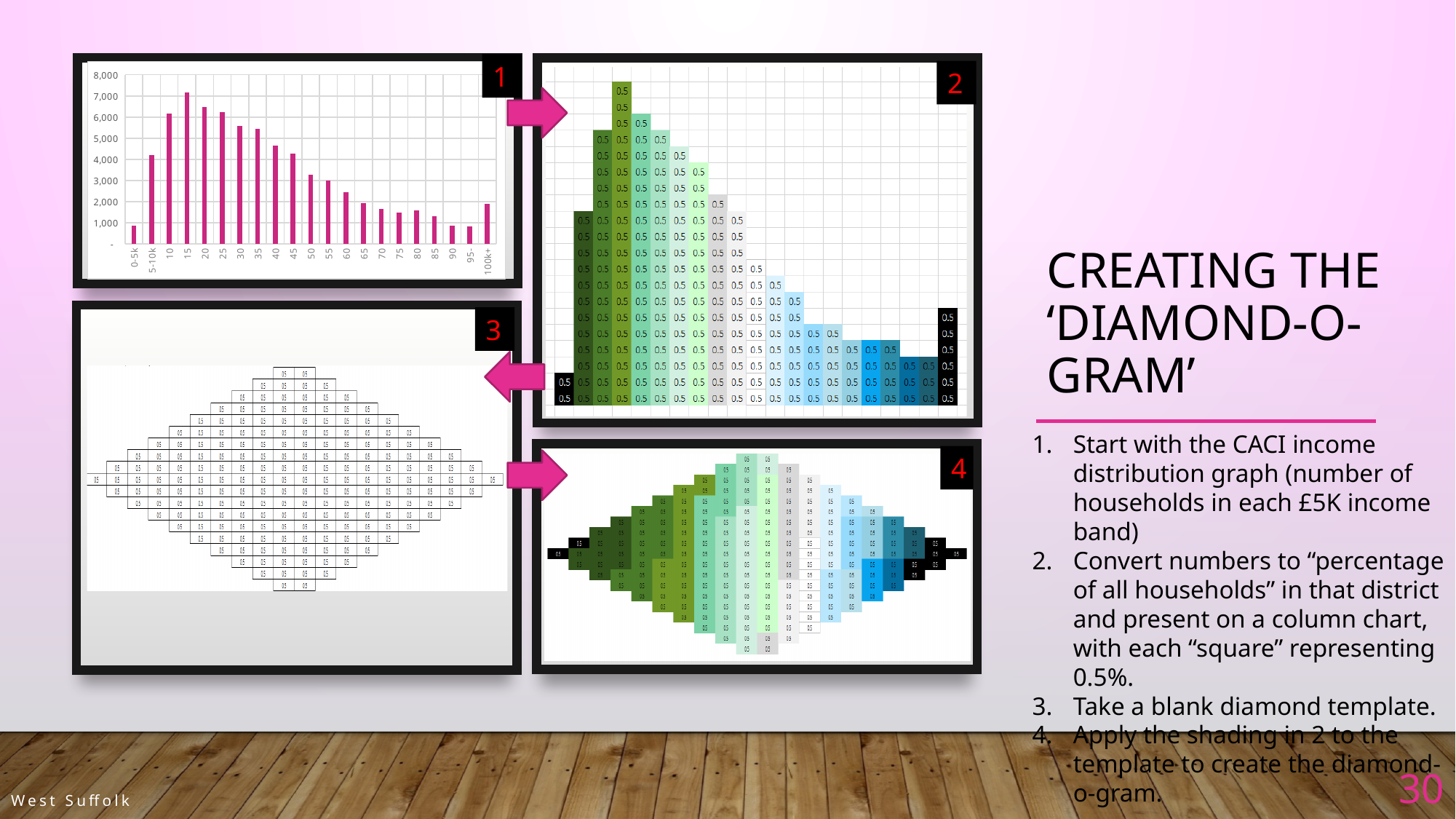
In the panel 1 bar chart, is the value for the 100k+ band greater or less than 2,000? less In the panel 1 bar chart, which income band has the highest number of households? 15 In the panel 1 bar chart, do the values rise or fall from the 15 band to the 90 band? fall In the panel 1 bar chart, is the value for the 60 band greater or less than 3,000? less In the panel 2 stacked column chart, what value is printed in each square? 0.5 In the panel 1 bar chart, is the value for the 0-5k band greater or less than 1,000? less How many income bands are shown on the x axis of the panel 1 bar chart? 21 What is the highest value shown on the y axis of the panel 1 bar chart? 8,000 What kind of chart is shown in panel 1 (top-left)? bar chart In the panel 1 bar chart, which is larger, the value for the 30 band or the 40 band? 30